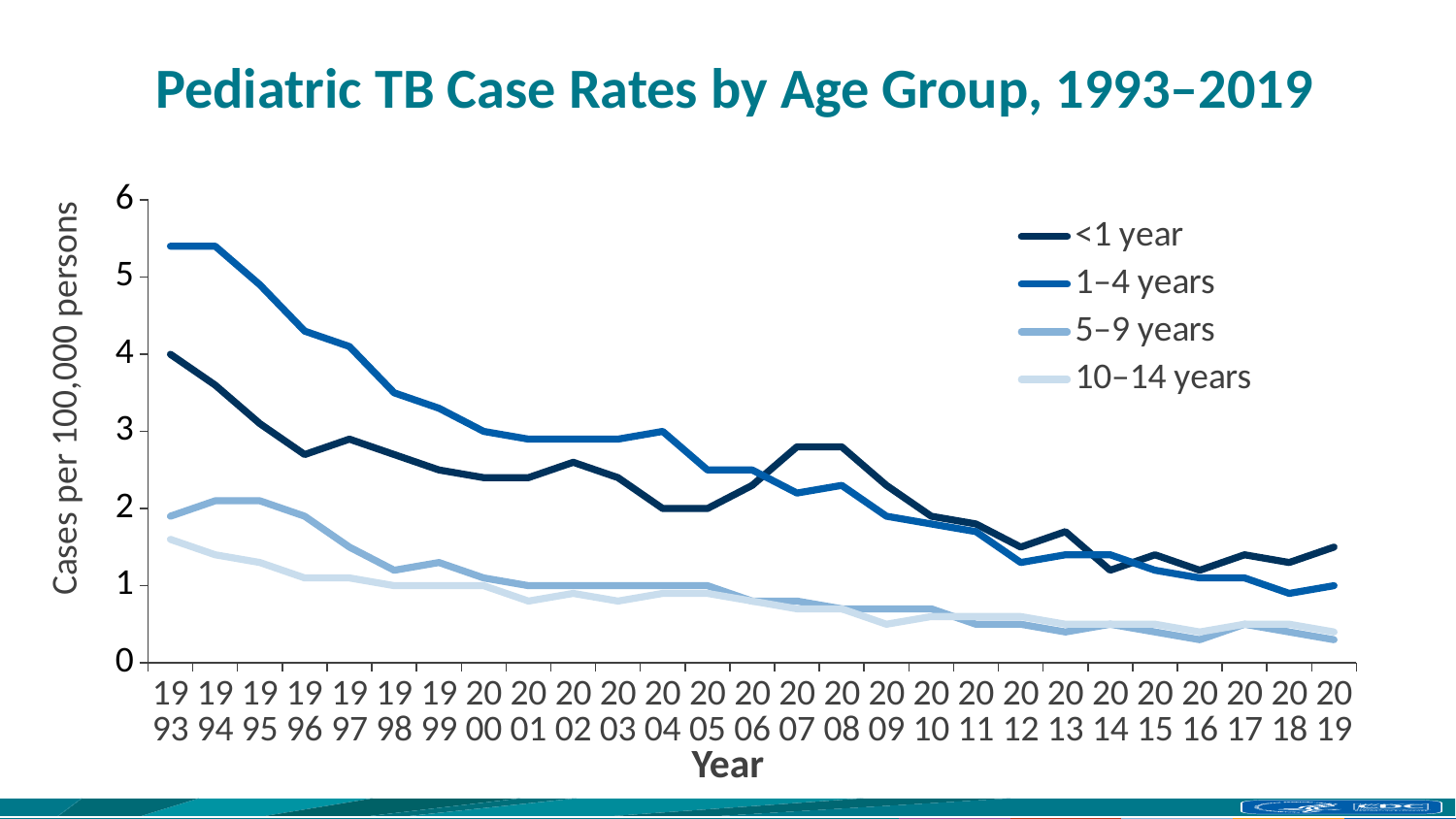
How many series does the legend list? 4 Is the value for <1 year in 2007 greater or less than 2? greater In 2007, which is larger: the case rate for <1 year or for 1–4 years? <1 year How many years are plotted along the x axis? 27 Which age group has the lowest case rate in 1993? 10–14 years Is the value for 1–4 years in 1993 greater or less than 5? greater What is the title of the y axis? Cases per 100,000 persons Does the case rate for 1–4 years generally rise or fall from 1993 to 2019? fall Which age group has the highest case rate in 2019? <1 year Which age group has the highest case rate in 1993? 1–4 years Is the value for 10–14 years in 2019 greater or less than 1? less What kind of chart is shown on the slide? line chart